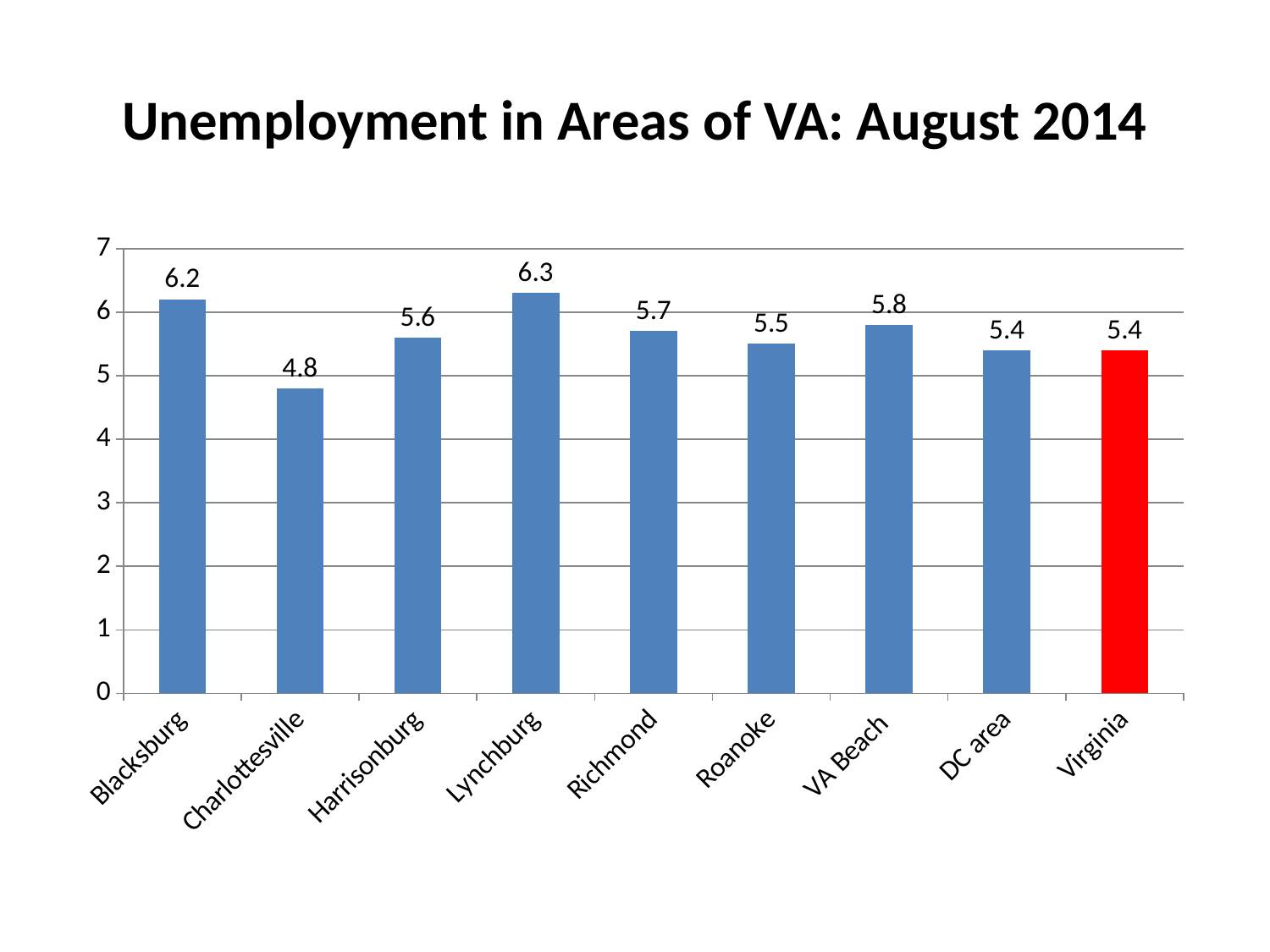
How many areas are shown on the chart? 9 What is the unemployment value for Virginia? 5.4 What is the unemployment value for Blacksburg? 6.2 What is the unemployment value for VA Beach? 5.8 What kind of chart is shown on the slide? Bar chart Which area has the highest unemployment value? Lynchburg What is the difference between the unemployment values for Lynchburg and Charlottesville? 1.5 What is the difference between the unemployment values for Blacksburg and Richmond? 0.5 What is the unemployment value for Charlottesville? 4.8 Which has a higher unemployment value, Harrisonburg or Roanoke? Harrisonburg What is the title of the chart? Unemployment in Areas of VA: August 2014 Which area has the lowest unemployment value? Charlottesville